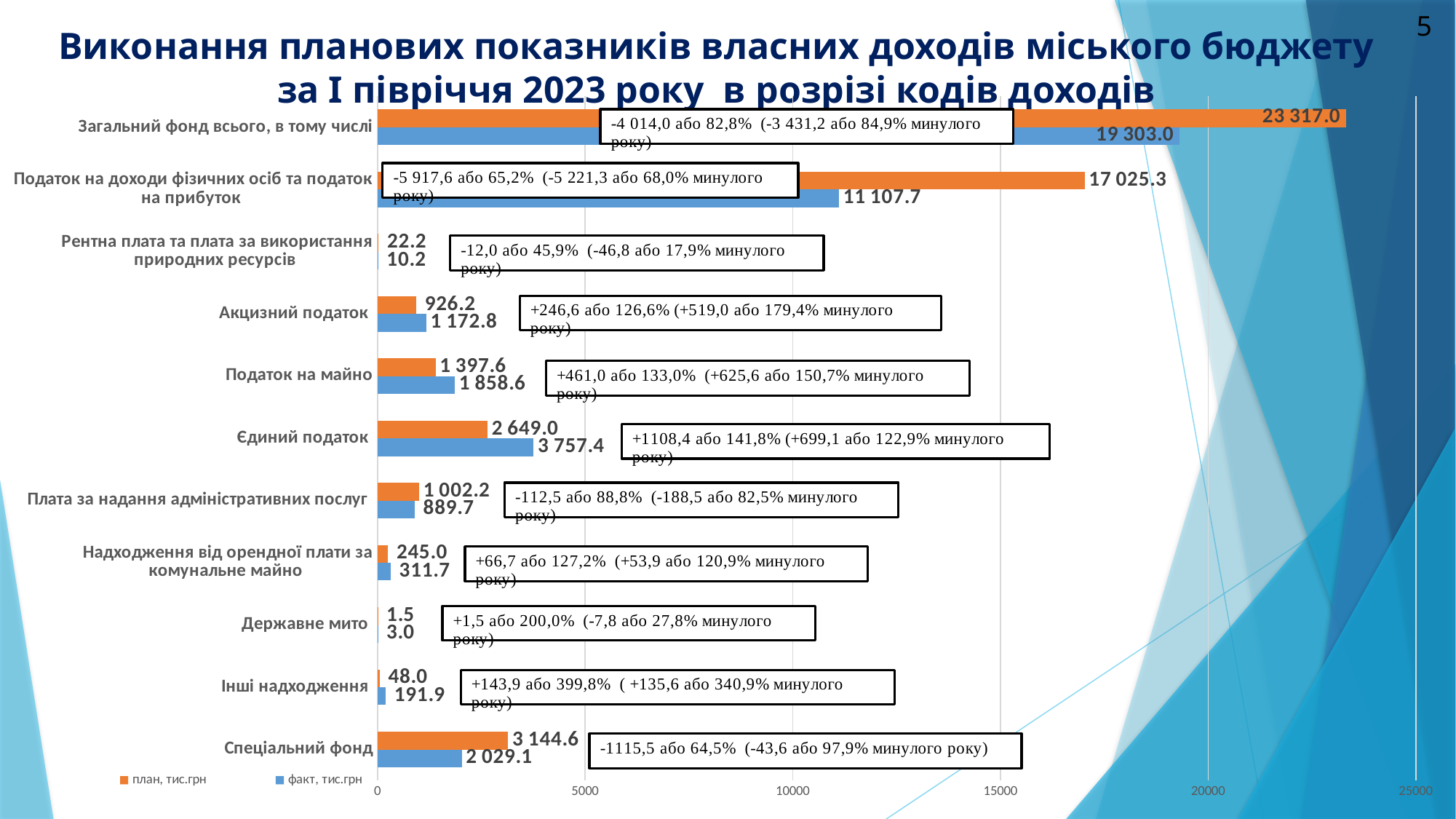
How many series does the legend list? 2 Which category has the lowest факт value? Державне мито For Акцизний податок, which is larger: the план value or the факт value? факт What is the план value for Єдиний податок? 2 649.0 What is the difference between the план and факт values for Загальний фонд всього, в тому числі? 4 014.0 What type of chart is shown on the slide? bar chart What is the факт value for Спеціальний фонд? 2 029.1 Which category has the highest план value? Загальний фонд всього, в тому числі What is the факт value for Податок на майно? 1 858.6 Is the факт value for Податок на доходи фізичних осіб та податок на прибуток greater or less than 10000? greater Which colour represents the факт series in the legend? blue How many categories are plotted on the chart? 11